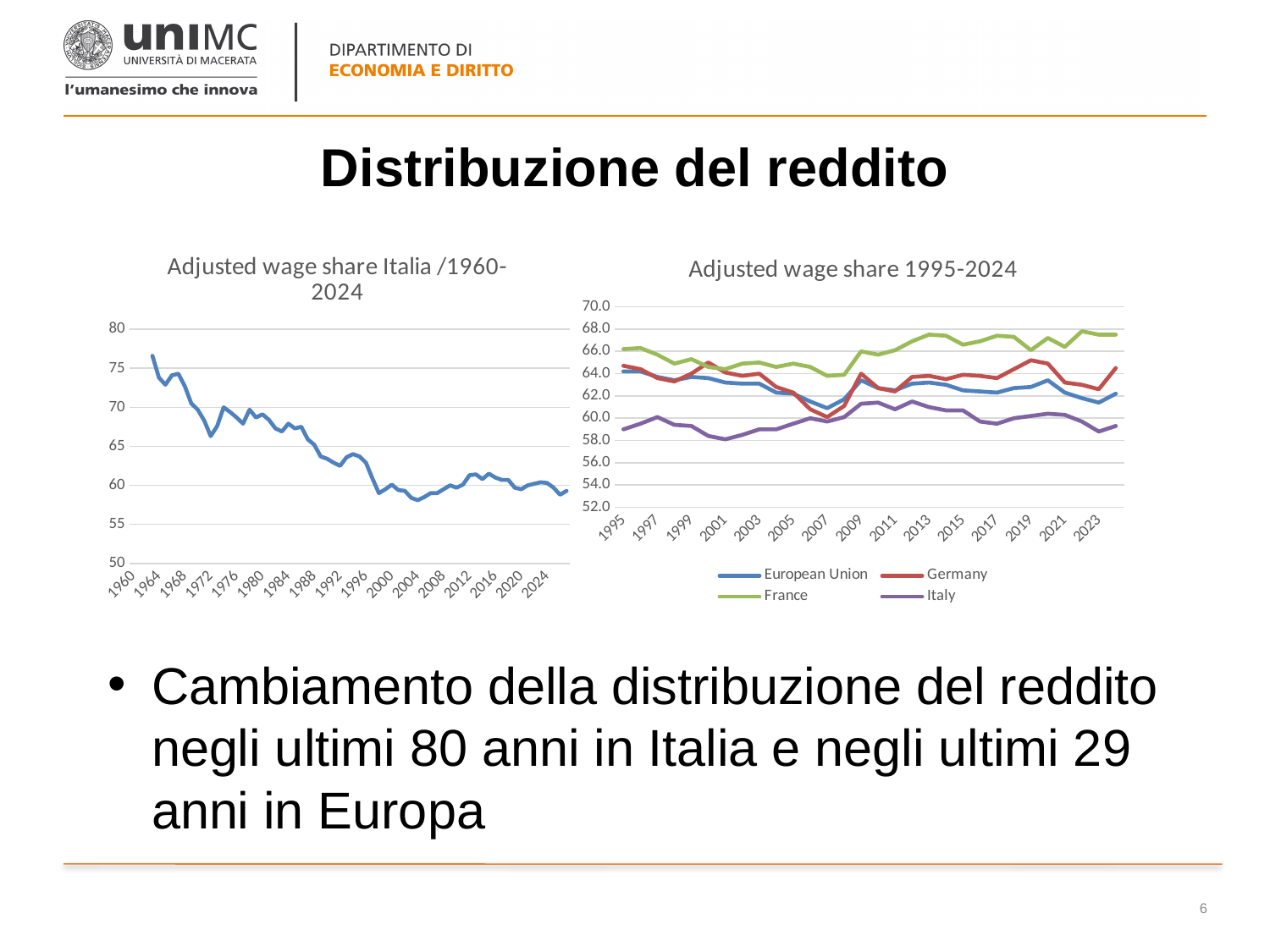
In the left chart 'Adjusted wage share Italia /1960-2024', is the value for 2004 greater or less than 60? less How many series does the legend of the right chart 'Adjusted wage share 1995-2024' list? 4 In the right chart 'Adjusted wage share 1995-2024', which is larger in 2024, Germany or European Union? Germany In the right chart 'Adjusted wage share 1995-2024', which series has the highest value in 2023? France What type of chart is the left chart titled 'Adjusted wage share Italia /1960-2024'? Line chart In the right chart 'Adjusted wage share 1995-2024', is the value for France in 2023 greater or less than 66? greater In the left chart 'Adjusted wage share Italia /1960-2024', do the values generally rise or fall from 1960 to 2024? Fall In the right chart 'Adjusted wage share 1995-2024', which series has the lowest value in 2023? Italy In the left chart 'Adjusted wage share Italia /1960-2024', is the value for 1972 greater or less than 70? less In the right chart 'Adjusted wage share 1995-2024', which series is shown in green? France